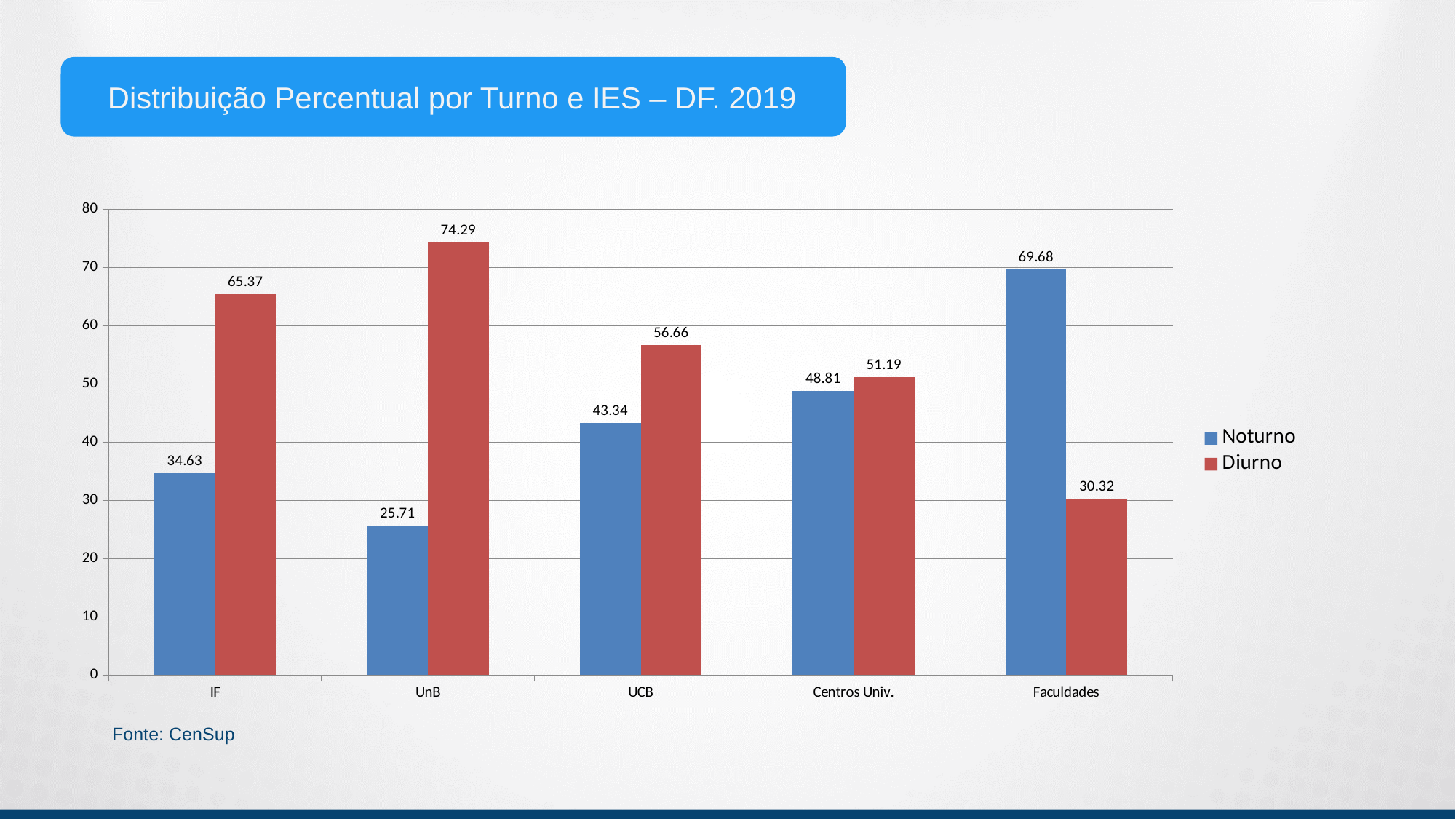
What is the source cited below the chart? CenSup What is the Diurno value for IF? 65.37 How many categories are shown on the x axis? 5 What is the Diurno value for Faculdades? 30.32 What kind of chart is shown on the slide? bar chart Which is larger for Centros Univ., the Noturno value or the Diurno value? Diurno How many series does the legend list? 2 Is the Noturno value for Faculdades greater or less than 60? greater What is the difference between the Diurno and Noturno values for UCB? 13.32 What is the Noturno value for UnB? 25.71 Which category has the highest Diurno value? UnB Which category has the lowest Noturno value? UnB